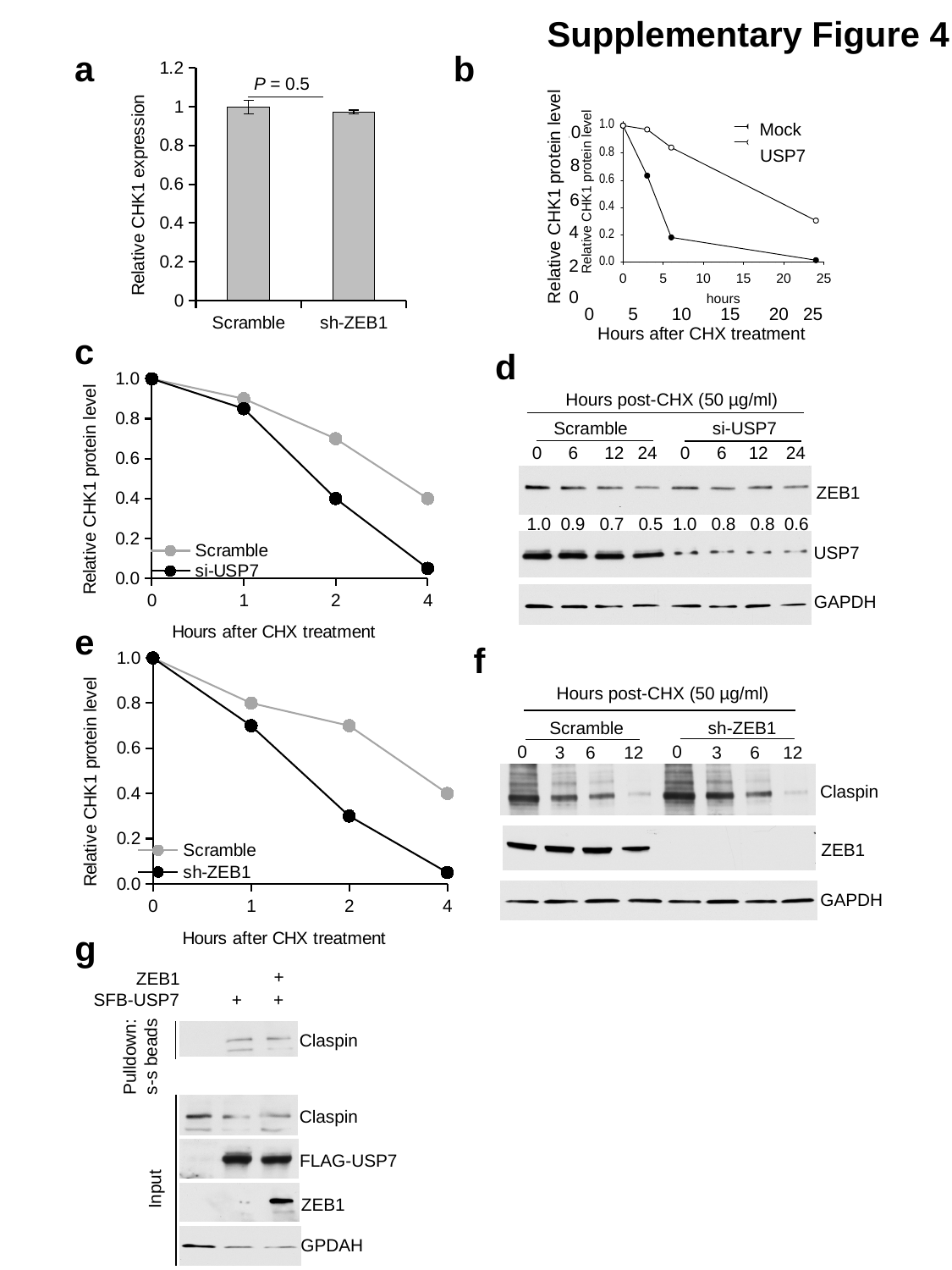
In panel b, how many series does the legend list? 2 In panel a, how many categories are plotted on the x axis? 2 In panel a, what kind of chart is shown? bar chart In panel e, what is the x-axis title? Hours after CHX treatment In panel e, is the value for sh-ZEB1 at 2 hours greater or less than 0.4? less In panel c, what is the relative CHK1 protein level for Scramble at 4 hours after CHX treatment? 0.4 In panel a, what P value is annotated above the bars? P = 0.5 In panel c, is the value for si-USP7 at 4 hours greater or less than 0.2? less In panel e, what is the relative CHK1 protein level for Scramble at 1 hour after CHX treatment? 0.8 In panel c, at 4 hours after CHX treatment, which series has the higher relative CHK1 protein level, Scramble or si-USP7? Scramble In panel c, do the relative CHK1 protein levels rise or fall as hours after CHX treatment increase? fall In panel c, how many series does the legend list? 2